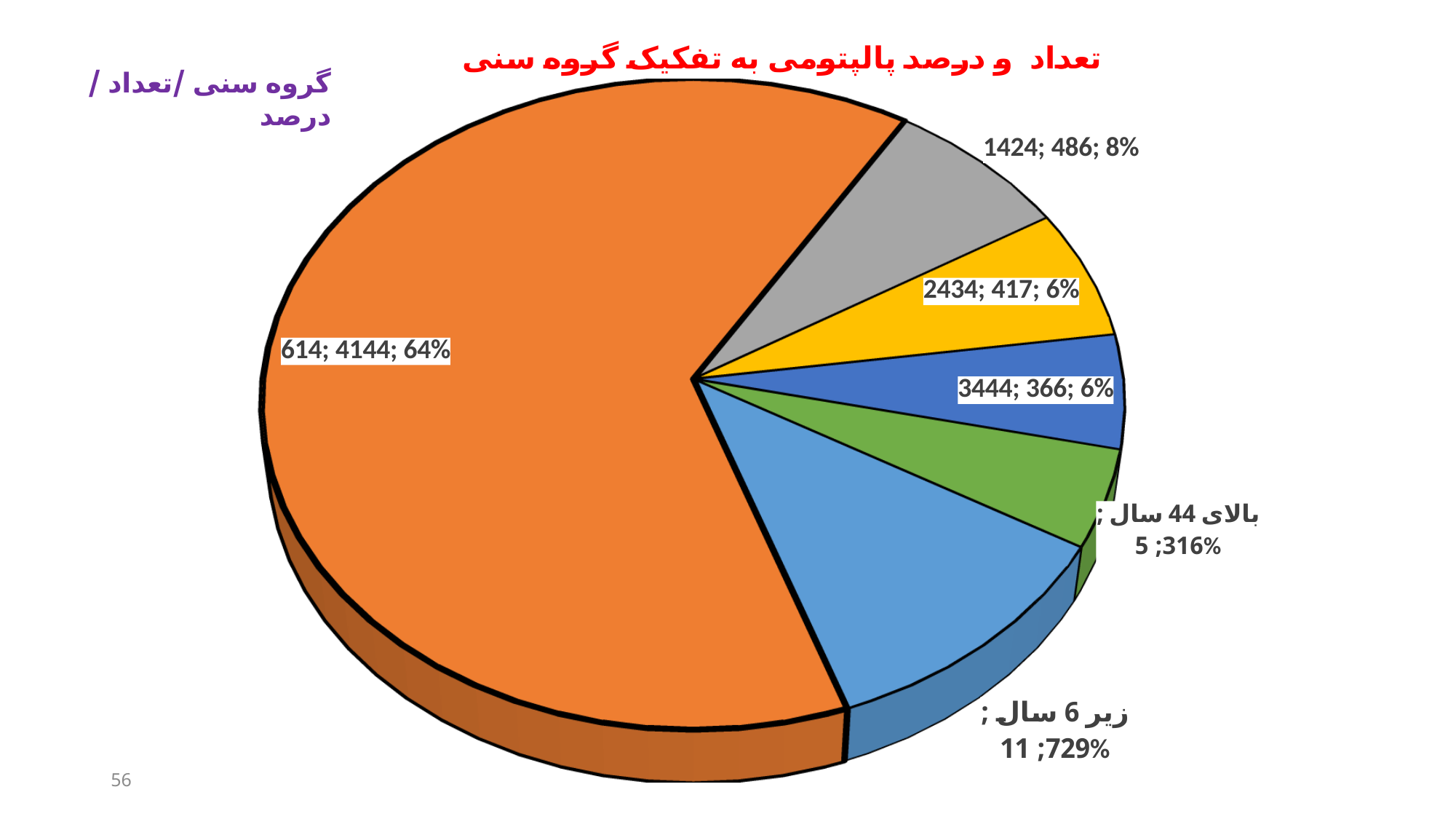
What is the difference between the counts for the slice labelled 614 and the slice labelled زیر 6 سال? 3415 Which slice of the pie chart is the largest? 614 What is the count shown for the slice labelled زیر 6 سال? 729 What percentage is shown for the slice labelled بالای 44 سال? 5% How many slices does the pie chart have? 6 What is the difference between the counts for the slices labelled 1424 and 2434? 69 What share of the pie does the slice labelled 1424 represent? 8% Which slice of the pie chart is the smallest? بالای 44 سال What kind of chart is shown on the slide? pie chart Which has a larger count, the slice labelled زیر 6 سال or the slice labelled 1424? زیر 6 سال What is the count shown for the slice labelled 614? 4144 What is the title of the chart? تعداد و درصد پالپتومی به تفکیک گروه سنی